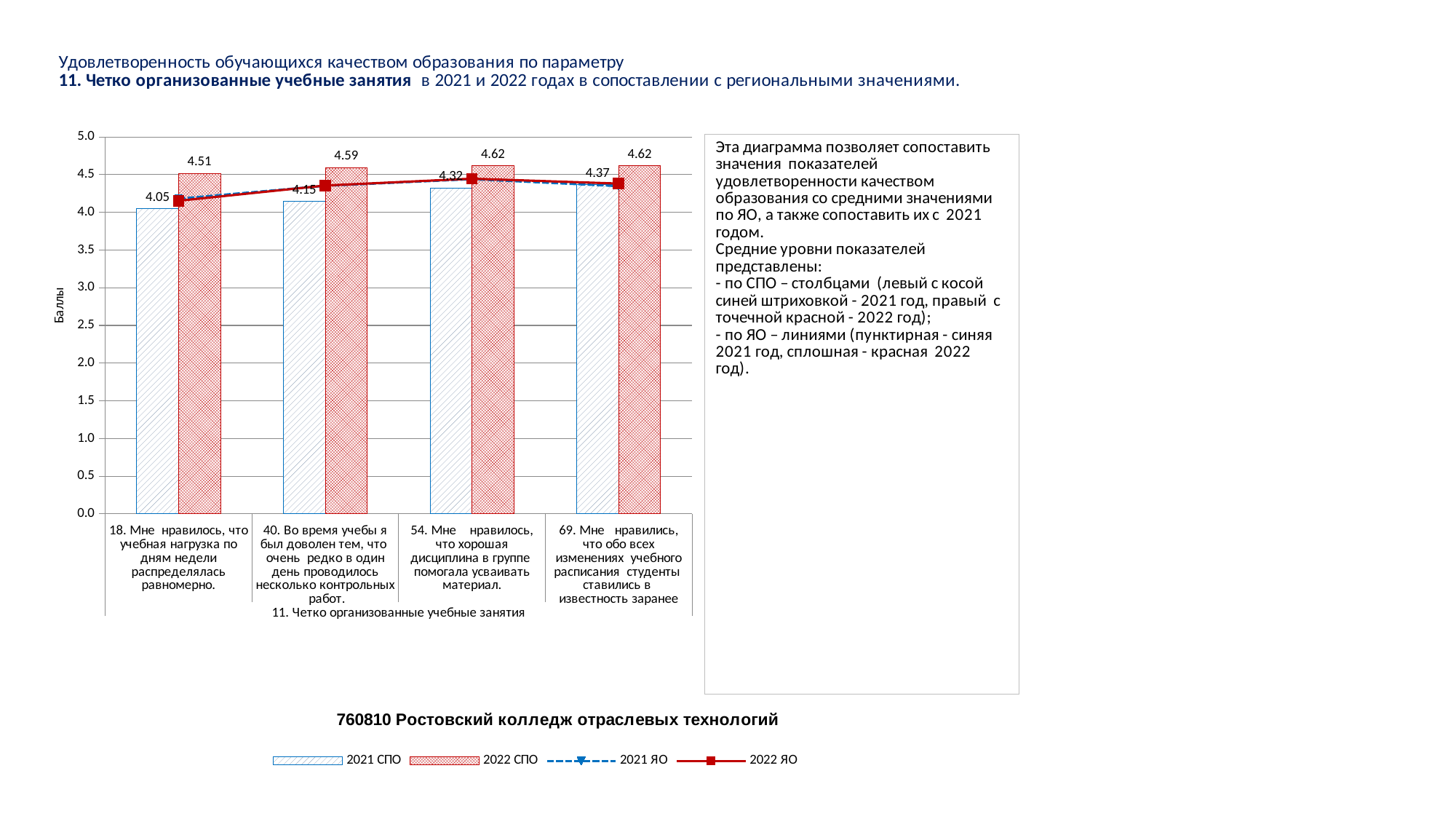
Which category has the lowest 2022 СПО value? 18. Мне нравилось, что учебная нагрузка по дням недели распределялась равномерно. How many series does the legend list? 4 What is the difference between the 2022 СПО and 2021 СПО values for category 18? 0.46 How many categories are shown on the x axis? 4 What is the 2022 СПО value for category 54 ("Мне нравилось, что хорошая дисциплина в группе помогала усваивать материал")? 4.62 Which is larger for category 40: the 2021 СПО value or the 2022 СПО value? 2022 СПО Which category has the lowest 2021 СПО value? 18. Мне нравилось, что учебная нагрузка по дням недели распределялась равномерно. What is the 2021 СПО value for category 69 ("Мне нравились, что обо всех изменениях учебного расписания студенты ставились в известность заранее")? 4.37 Do the 2021 СПО values rise or fall from left to right across the categories? rise What is the 2022 СПО value for category 18 ("Мне нравилось, что учебная нагрузка по дням недели распределялась равномерно")? 4.51 What is the 2021 СПО value for category 40 ("Во время учебы я был доволен тем, что очень редко в один день проводилось несколько контрольных работ")? 4.15 Is the 2021 СПО value for category 54 greater or less than 4.0? greater